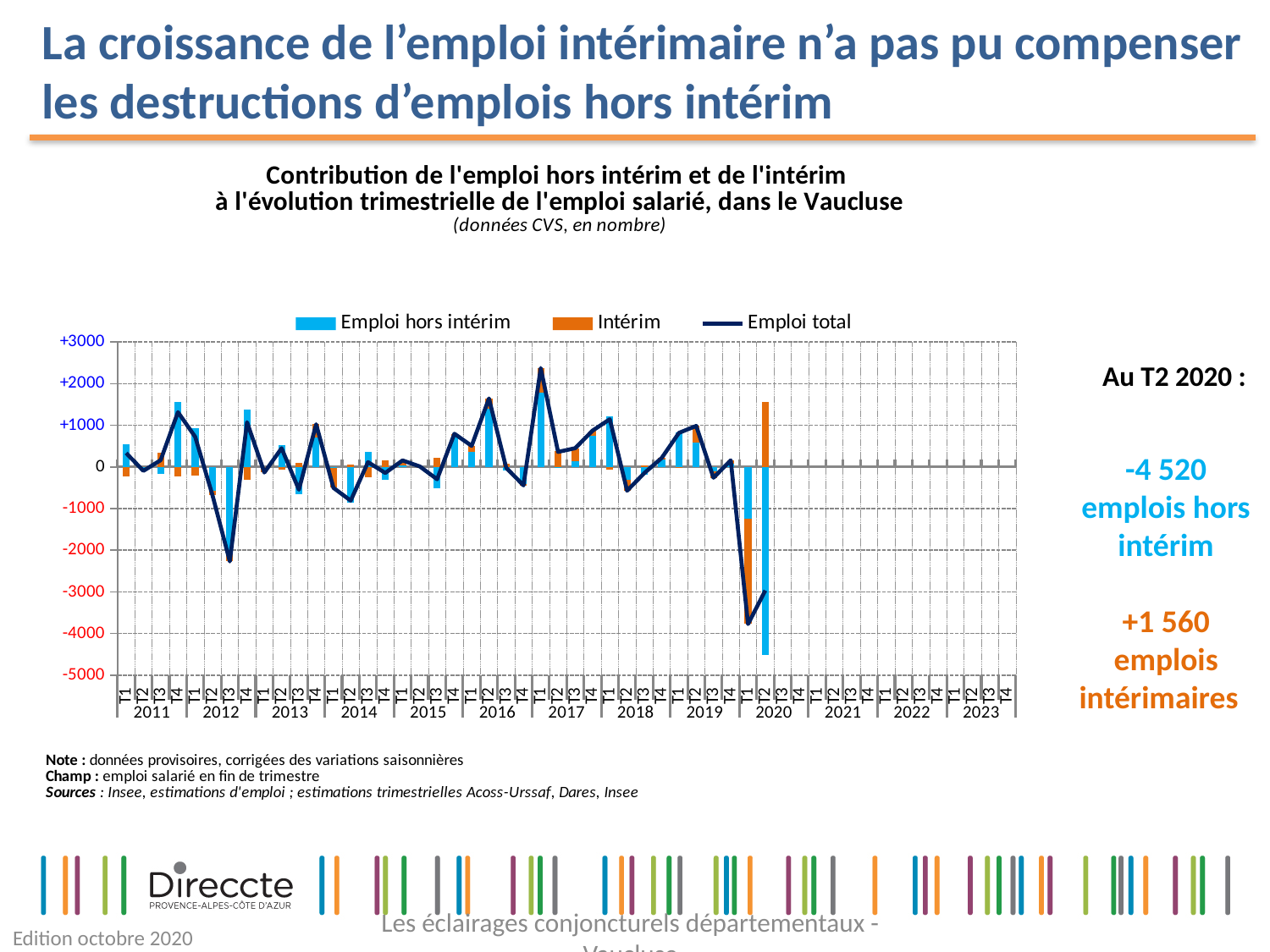
According to the slide, what is the value for Emploi hors intérim at T2 2020? -4 520 At T2 2020, which is larger: the value for Emploi hors intérim or the value for Intérim? Intérim Is the value of Emploi total at T1 2017 greater or less than +2000? greater Is the value for Emploi hors intérim at T2 2020 greater or less than -4000? less Using the two values printed for T2 2020, what is the combined change in employment (hors intérim plus intérim)? -2 960 According to the slide, what is the value for Intérim at T2 2020? +1 560 In which quarter does Emploi hors intérim reach its lowest value? T2 2020 What kind of chart is shown on the slide? Combined bar and line chart Which colour represents the Intérim series in the legend? Orange How many series does the chart legend list? 3 Is the value for Intérim at T2 2020 greater or less than +1000? greater